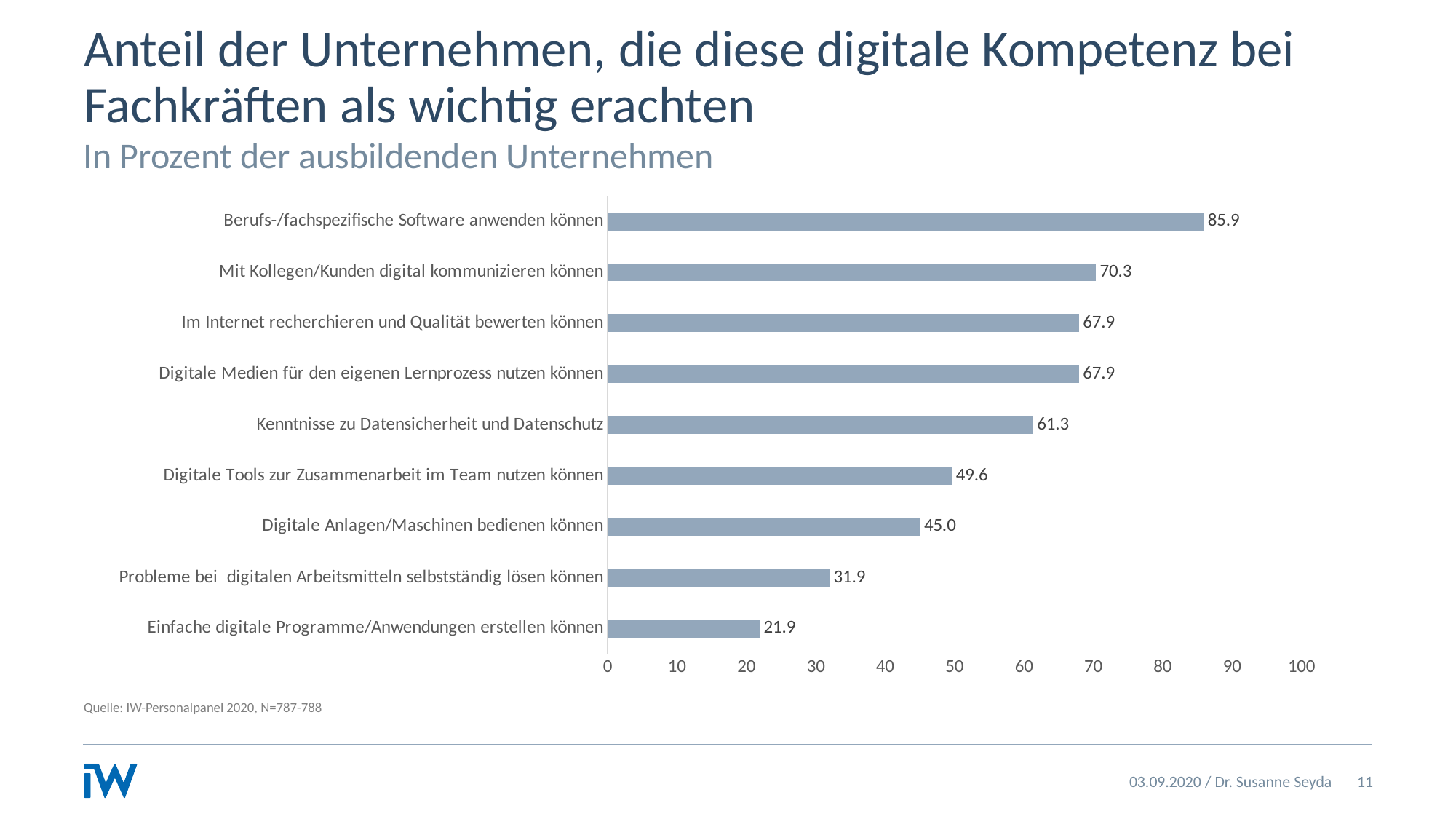
Is the value for "Digitale Anlagen/Maschinen bedienen können" greater or less than 50? less How many categories are shown in the chart? 9 What is the subtitle of the chart on the slide? In Prozent der ausbildenden Unternehmen What kind of chart is shown on the slide? Bar chart Which category has the lowest value? Einfache digitale Programme/Anwendungen erstellen können What is the value for "Einfache digitale Programme/Anwendungen erstellen können"? 21.9 Which category has the highest value? Berufs-/fachspezifische Software anwenden können What is the value for "Kenntnisse zu Datensicherheit und Datenschutz"? 61.3 What is the highest tick value shown on the x axis? 100 Which is larger: the value for "Digitale Tools zur Zusammenarbeit im Team nutzen können" or for "Probleme bei digitalen Arbeitsmitteln selbstständig lösen können"? Digitale Tools zur Zusammenarbeit im Team nutzen können What is the difference between the values for "Mit Kollegen/Kunden digital kommunizieren können" and "Digitale Anlagen/Maschinen bedienen können"? 25.3 What is the value for "Berufs-/fachspezifische Software anwenden können"? 85.9